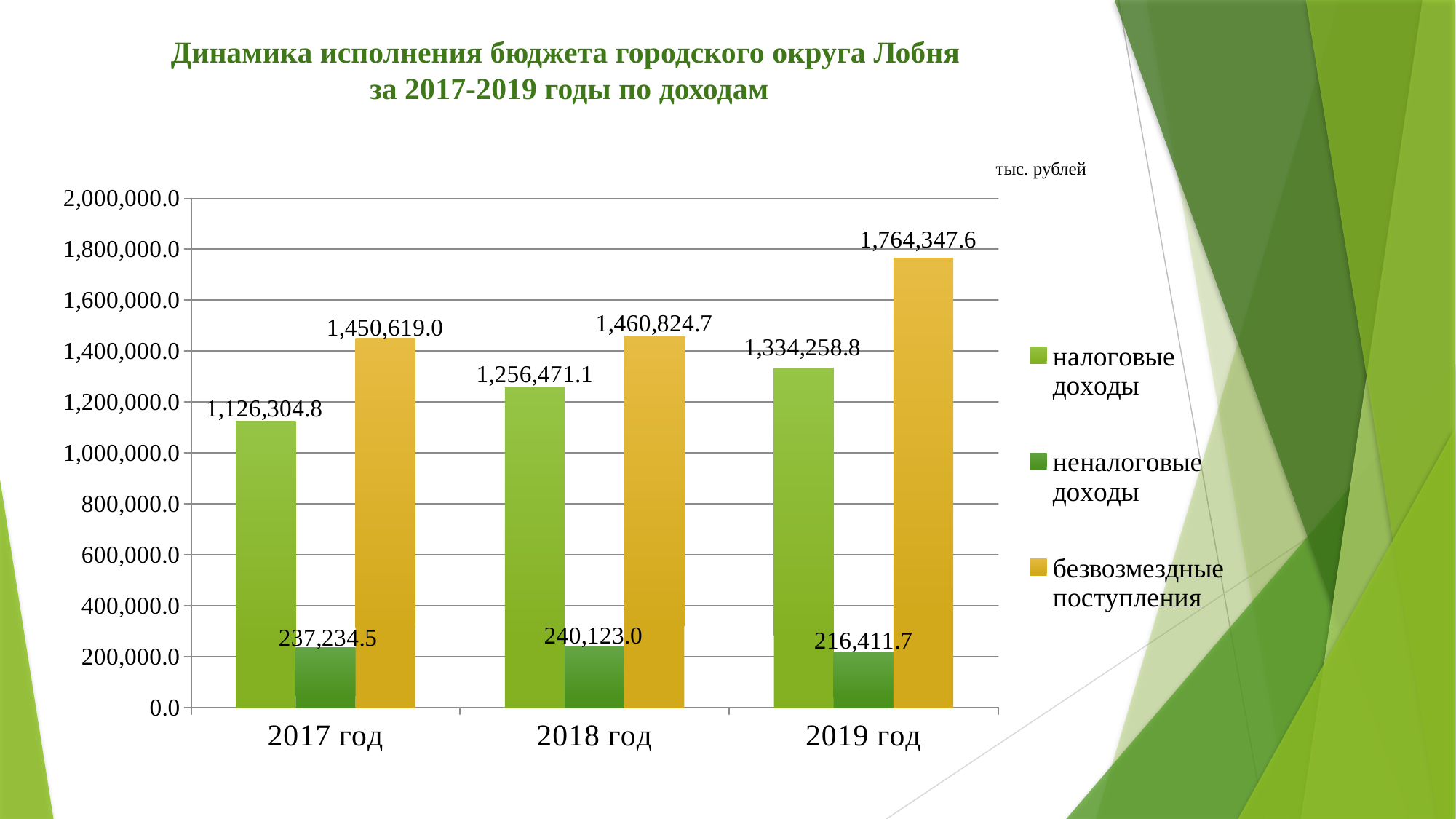
Which is larger in 2018 год: налоговые доходы or безвозмездные поступления? безвозмездные поступления How many year categories are shown on the x axis? 3 In which year is безвозмездные поступления the highest? 2019 год What is the difference between налоговые доходы in 2019 год and in 2017 год? 207,954.0 What is the value of безвозмездные поступления for 2019 год? 1,764,347.6 How many series does the legend list? 3 In which year is неналоговые доходы the lowest? 2019 год What is the value of налоговые доходы for 2018 год? 1,256,471.1 What unit is indicated above the chart? тыс. рублей Do the values of налоговые доходы rise or fall from 2017 год to 2019 год? rise What is the value of неналоговые доходы for 2017 год? 237,234.5 What type of chart is shown on the slide? bar chart